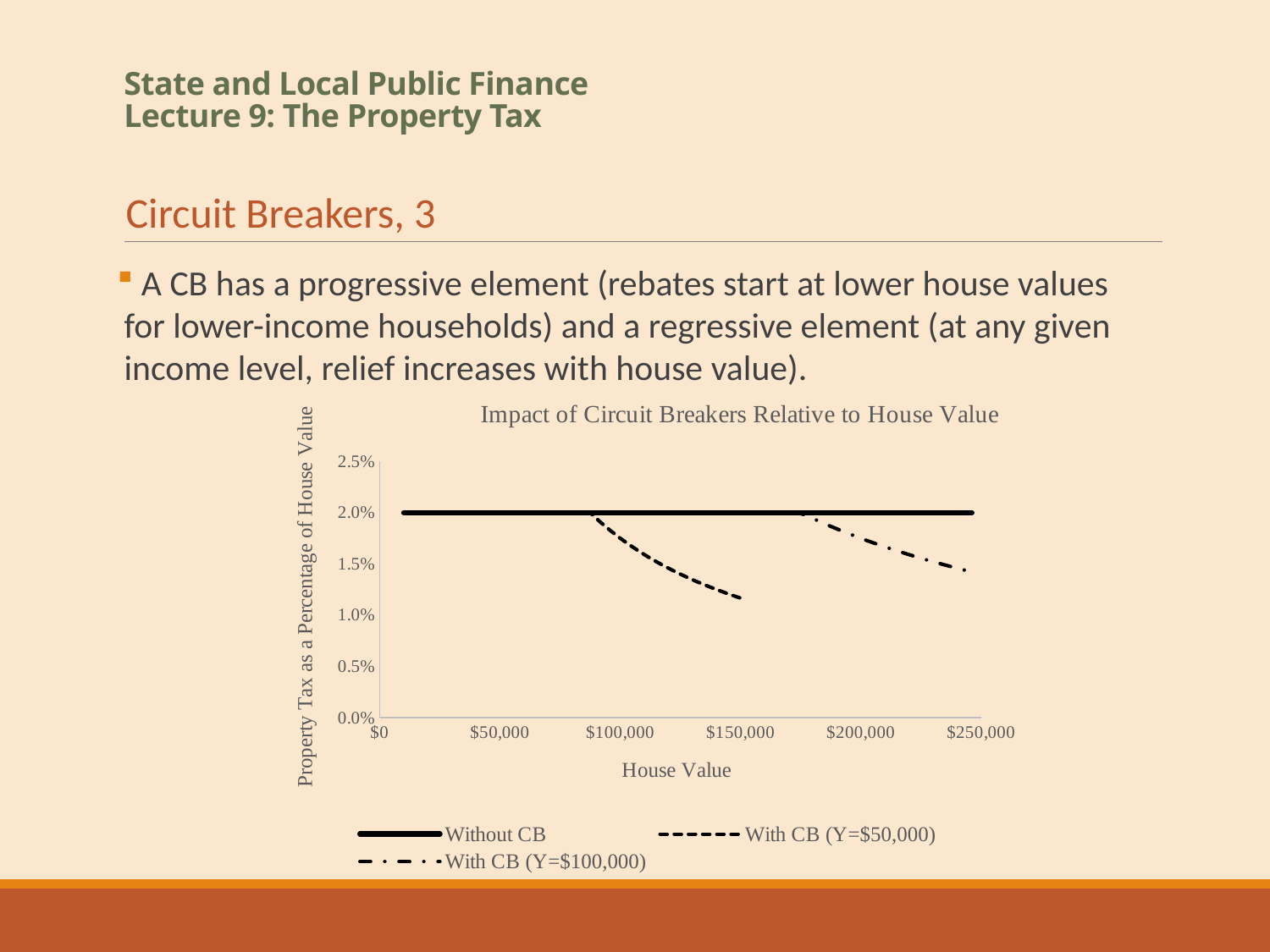
Is the value of the With CB (Y=$100,000) series at a house value of $250,000 greater or less than 2.0%? less Is the value of the With CB (Y=$50,000) series at a house value of $150,000 greater or less than 1.5%? less At a house value of $250,000, which series has the larger value: Without CB or With CB (Y=$100,000)? Without CB Does the Without CB series rise, fall, or stay flat as house value increases? stay flat Is the value of the With CB (Y=$50,000) series at a house value of $150,000 greater or less than 1.0%? greater What is the title of the chart? Impact of Circuit Breakers Relative to House Value What is the label of the vertical axis of the chart? Property Tax as a Percentage of House Value At a house value of $150,000, which series has the larger value: Without CB or With CB (Y=$50,000)? Without CB What kind of chart is shown on the slide? line chart How many series does the legend of the chart list? 3 Does the With CB (Y=$50,000) series rise or fall as house value increases beyond $100,000? fall What is the value of the Without CB series across all house values? 2.0%